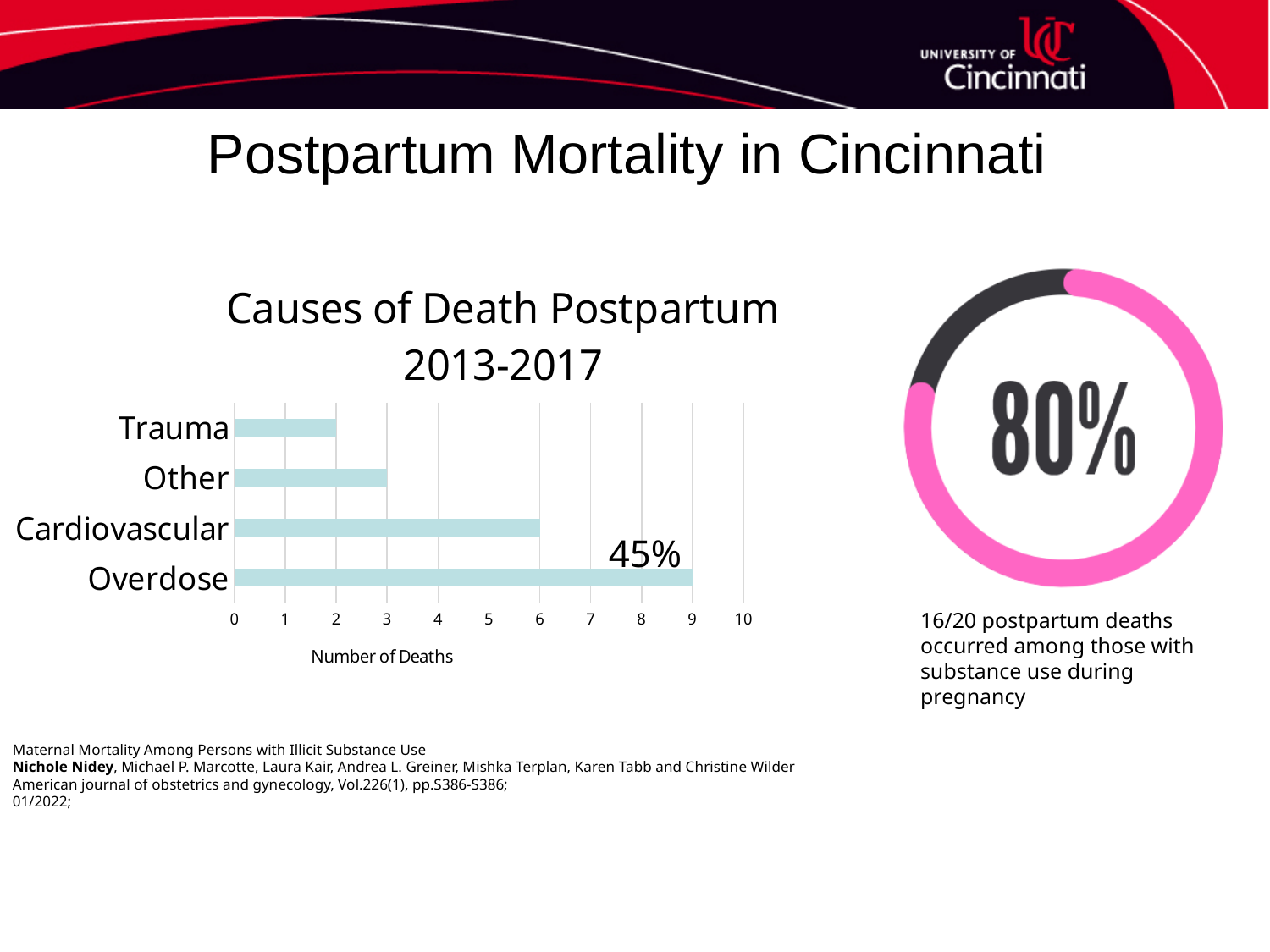
How many causes of death are listed in the 'Causes of Death Postpartum 2013-2017' chart? 4 In the 'Causes of Death Postpartum 2013-2017' chart, how many deaths are shown for Cardiovascular? 6 In the 'Causes of Death Postpartum 2013-2017' chart, how many deaths are shown for Other? 3 In the 'Causes of Death Postpartum 2013-2017' chart, which has more deaths, Cardiovascular or Other? Cardiovascular In the 'Causes of Death Postpartum 2013-2017' chart, which cause of death has the highest number of deaths? Overdose In the 'Causes of Death Postpartum 2013-2017' chart, which cause of death has the lowest number of deaths? Trauma In the 'Causes of Death Postpartum 2013-2017' chart, is the value for Overdose greater or less than 8? greater In the 'Causes of Death Postpartum 2013-2017' chart, what is the difference in number of deaths between Overdose and Cardiovascular? 3 What type of chart is 'Causes of Death Postpartum 2013-2017'? bar chart In the 'Causes of Death Postpartum 2013-2017' chart, how many deaths are shown for Overdose? 9 What percentage label is shown on the Overdose bar in the 'Causes of Death Postpartum 2013-2017' chart? 45% In the 'Causes of Death Postpartum 2013-2017' chart, how many deaths are shown for Trauma? 2